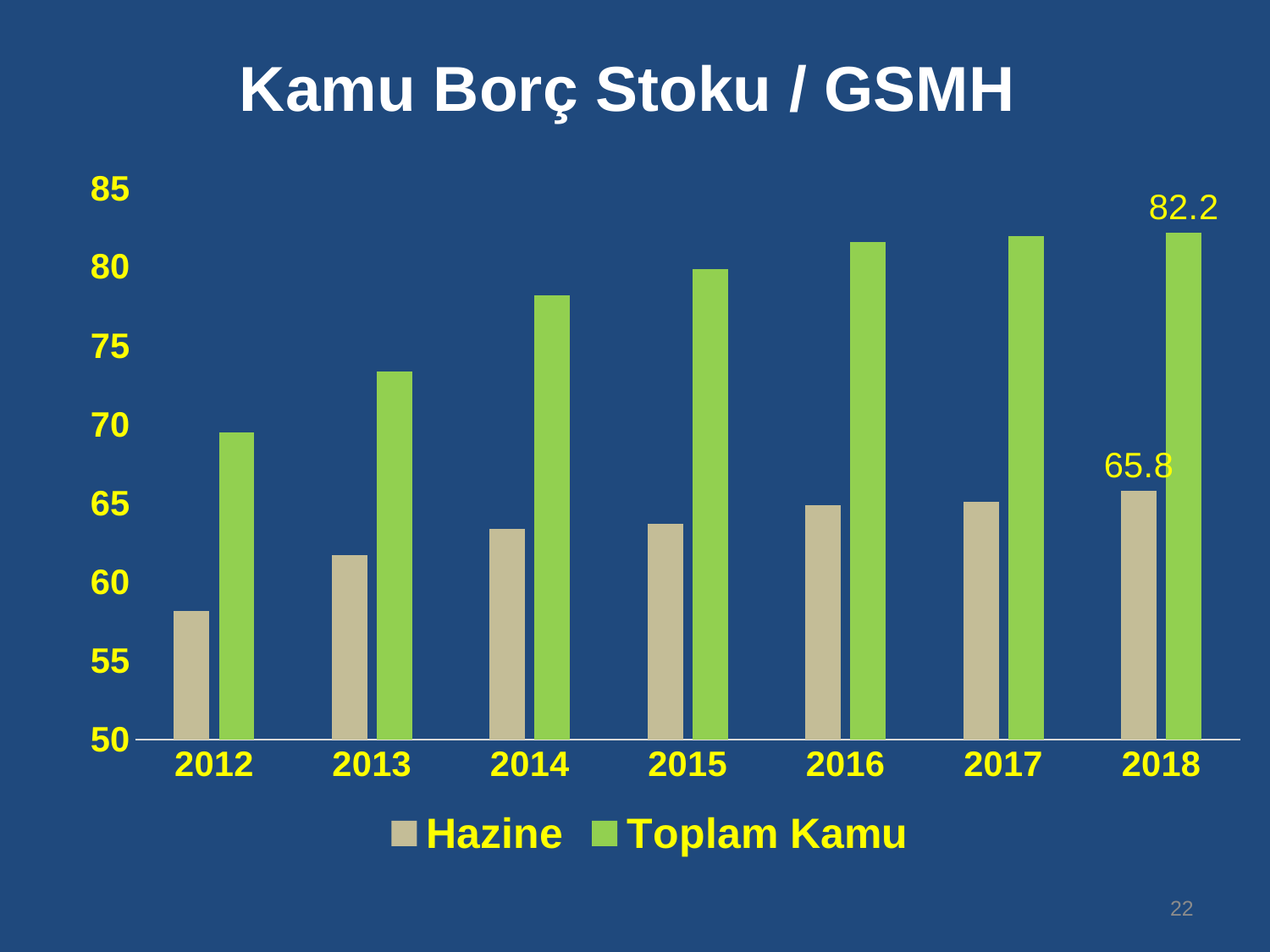
What is the value for Hazine in 2018? 65.8 Is the value for Toplam Kamu in 2014 greater or less than 75? greater How many years are shown on the x axis? 7 What is the difference between the Toplam Kamu and Hazine values in 2018? 16.4 In 2012, which series has the larger value, Hazine or Toplam Kamu? Toplam Kamu What is the value for Toplam Kamu in 2018? 82.2 Do the Toplam Kamu values rise or fall from 2012 to 2018? rise Is the value for Hazine in 2012 greater or less than 60? less How many series does the legend list? 2 In which year is the Toplam Kamu value lowest? 2012 What kind of chart is shown on the slide? bar chart In which year is the Hazine value lowest? 2012